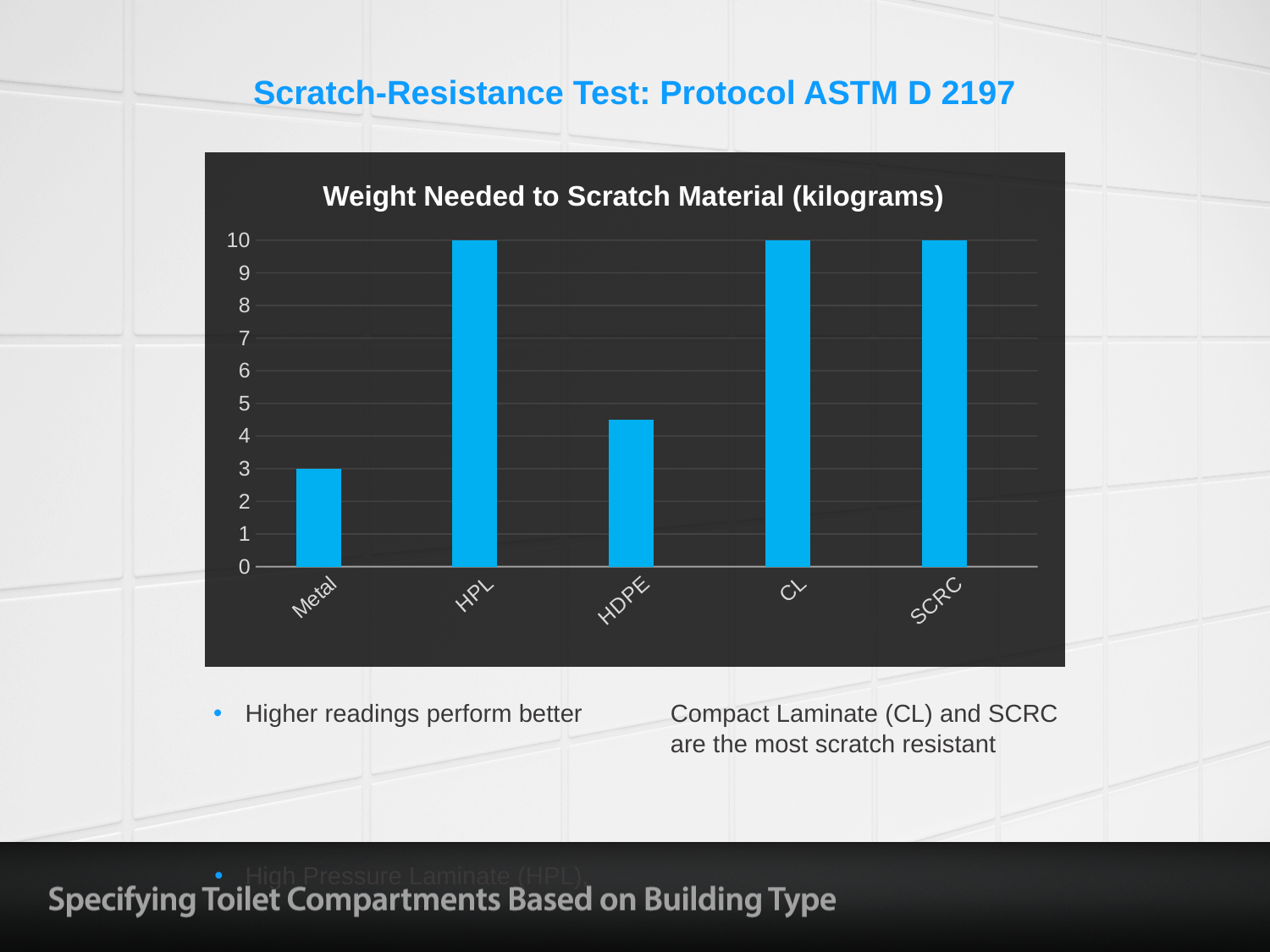
Is the value for HDPE greater or less than 4? greater What is the value for Metal? 3 Which has the larger value, HDPE or Metal? HDPE Which material has the lowest value? Metal What is the value for HPL? 10 What is the title of the chart? Weight Needed to Scratch Material (kilograms) What kind of chart is shown on the slide? bar chart What is the value for CL? 10 How many materials are plotted on the chart? 5 What is the difference between the values for HPL and Metal? 7 Is the value for HDPE greater or less than 5? less What is the value for SCRC? 10